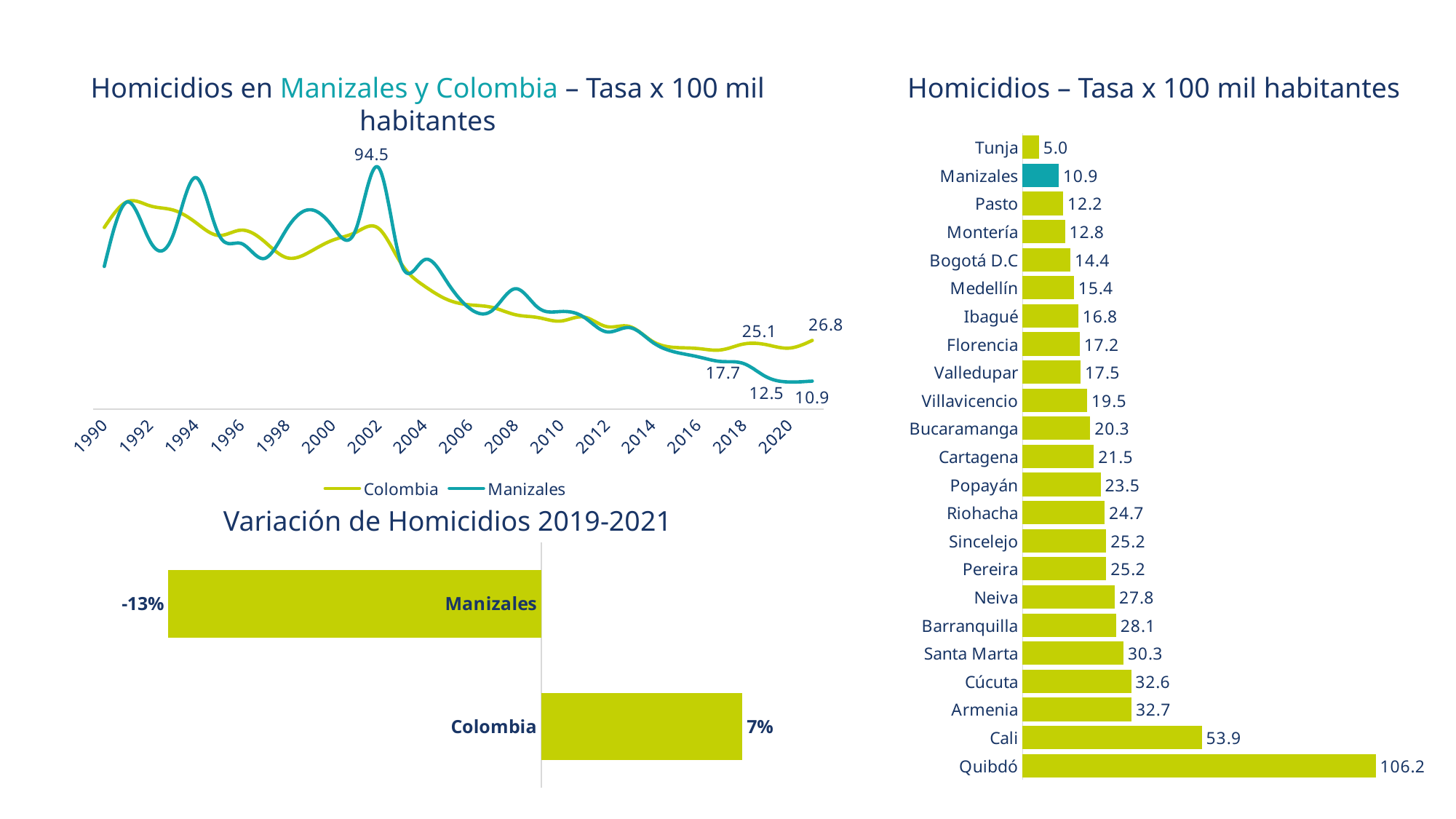
In the line chart 'Homicidios en Manizales y Colombia – Tasa x 100 mil habitantes', what is the highest labelled value on the Manizales line? 94.5 What kind of chart is 'Homicidios – Tasa x 100 mil habitantes' on the right of the slide? Bar chart In the chart 'Homicidios – Tasa x 100 mil habitantes' on the right, which city has the highest rate? Quibdó In the chart 'Variación de Homicidios 2019-2021' at the bottom left, what is the value for Colombia? 7% In the chart 'Homicidios – Tasa x 100 mil habitantes' on the right, what is the value for Quibdó? 106.2 In the chart 'Homicidios – Tasa x 100 mil habitantes' on the right, what is the value for Manizales? 10.9 In the chart 'Homicidios – Tasa x 100 mil habitantes' on the right, which is larger, the value for Medellín or the value for Bogotá D.C? Medellín In the chart 'Homicidios – Tasa x 100 mil habitantes' on the right, which city has the lowest rate? Tunja In the chart 'Variación de Homicidios 2019-2021' at the bottom left, what is the value for Manizales? -13% In the line chart 'Homicidios en Manizales y Colombia – Tasa x 100 mil habitantes', how many series does the legend list? 2 In the chart 'Homicidios – Tasa x 100 mil habitantes' on the right, what is the difference between the values for Quibdó and Cali? 52.3 In the chart 'Homicidios – Tasa x 100 mil habitantes' on the right, how many cities are shown? 23